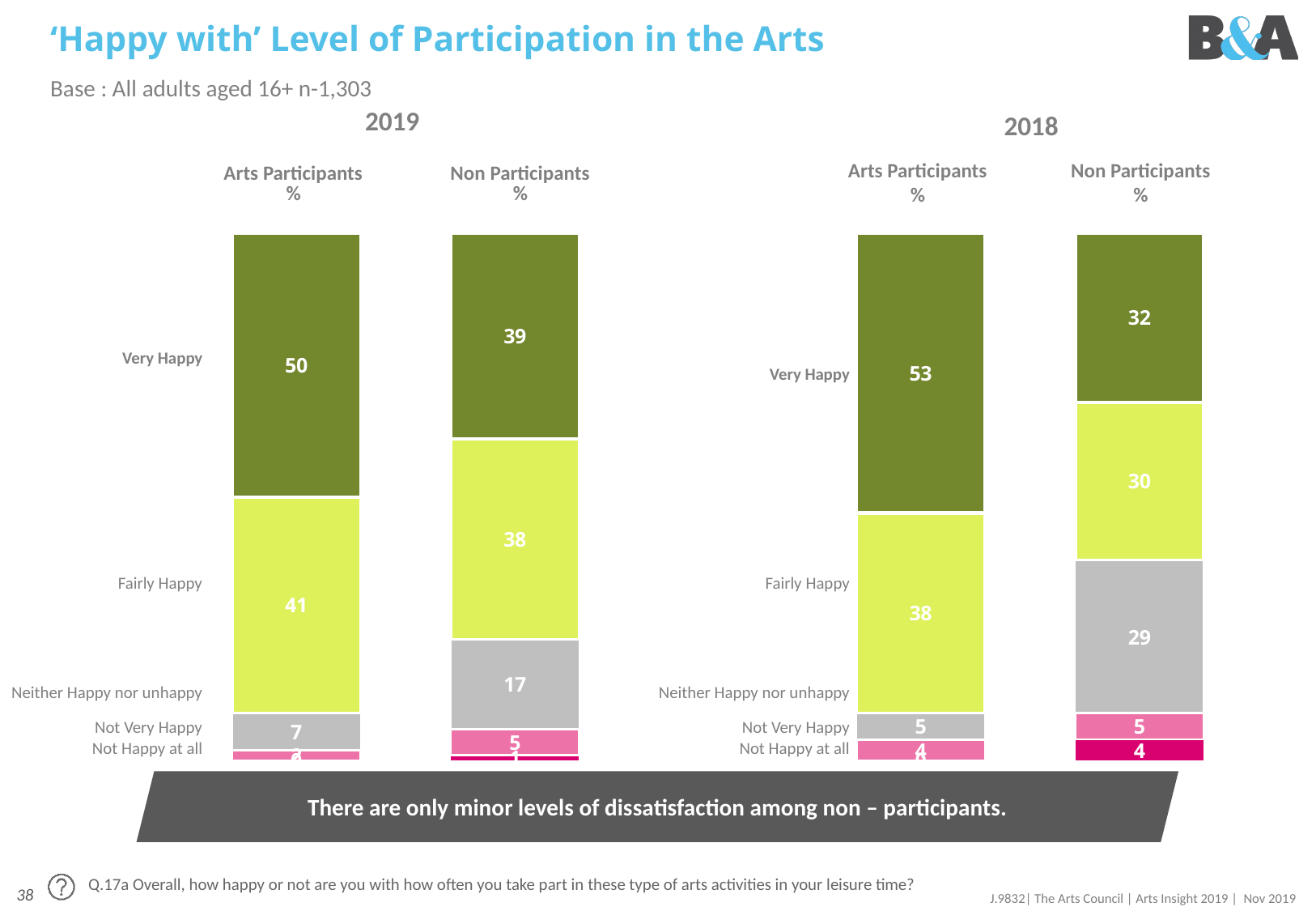
How many bars does the 2018 chart contain? 2 In the 2019 chart, what is the combined percentage of Non Participants who are Very Happy or Fairly Happy? 77 In the 2019 chart, what is the difference between the Very Happy percentages for Arts Participants and Non Participants? 11 In the 2019 chart, what percentage of Non Participants are Fairly Happy? 38 In the 2018 chart, which group has the larger Very Happy percentage, Arts Participants or Non Participants? Arts Participants In the 2019 chart, which segment is the largest in the Non Participants bar? Very Happy In the 2018 chart, what percentage of Arts Participants are Very Happy? 53 In the 2019 chart, what percentage of Arts Participants are Very Happy? 50 In the 2018 chart, what percentage of Non Participants are Neither Happy nor unhappy? 29 What kind of chart is used on this slide? Stacked bar chart In the 2018 chart, which segment is the smallest in the Non Participants bar? Not Happy at all In the 2019 chart, what percentage of Non Participants are Neither Happy nor unhappy? 17